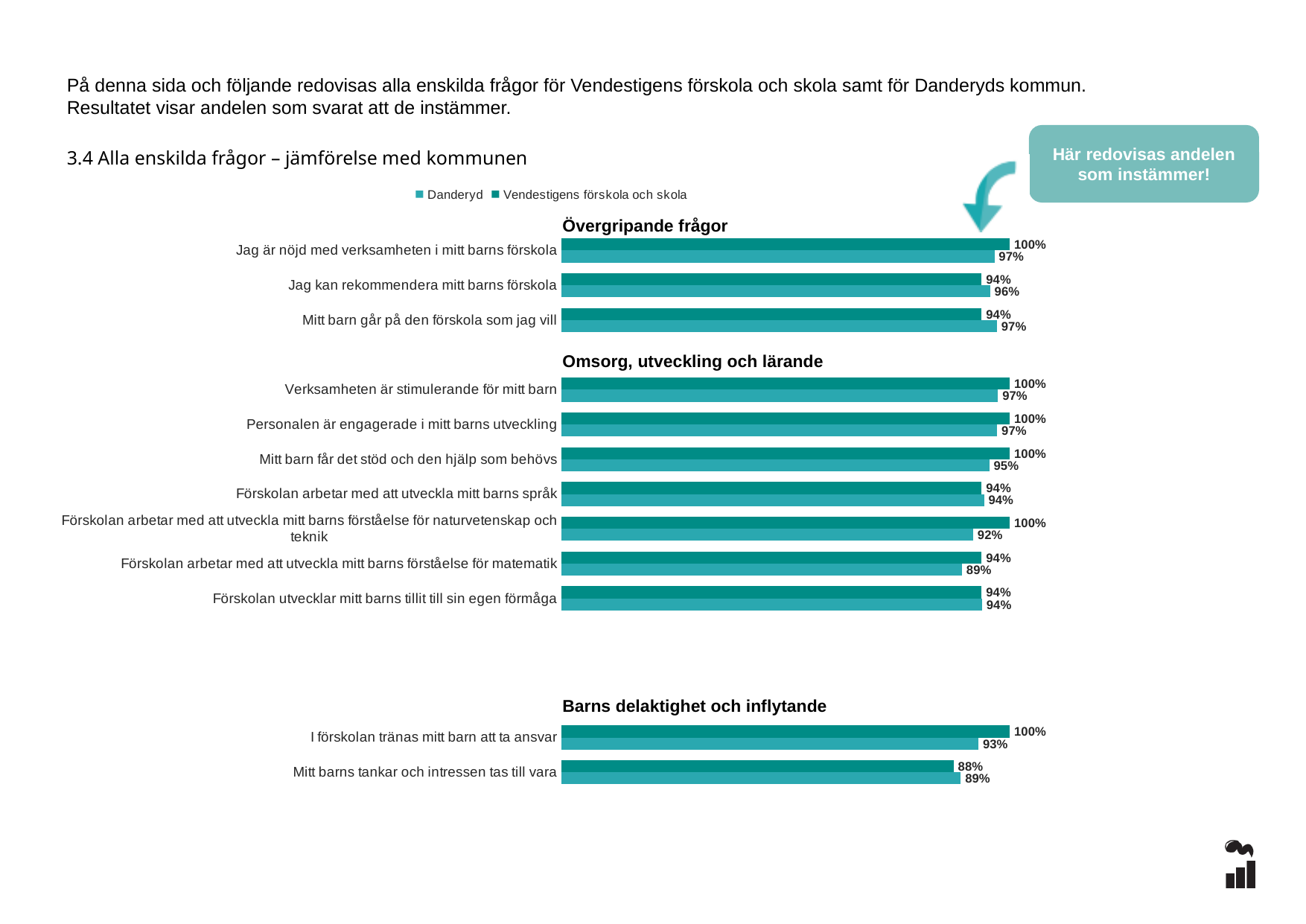
How many series does the legend list? 2 In the 'Barns delaktighet och inflytande' chart, what is the difference between Danderyd and Vendestigens förskola och skola on 'Mitt barns tankar och intressen tas till vara'? 1 percentage point In the 'Övergripande frågor' chart, what is the value for Vendestigens förskola och skola on 'Jag är nöjd med verksamheten i mitt barns förskola'? 100% In the 'Övergripande frågor' chart, which is larger on 'Mitt barn går på den förskola som jag vill': Vendestigens förskola och skola or Danderyd? Danderyd How many questions are shown in the 'Omsorg, utveckling och lärande' chart? 7 In the 'Omsorg, utveckling och lärande' chart, what is the difference between Vendestigens förskola och skola and Danderyd on 'Förskolan arbetar med att utveckla mitt barns förståelse för naturvetenskap och teknik'? 8 percentage points In the 'Övergripande frågor' chart, what is the value for Danderyd on 'Jag kan rekommendera mitt barns förskola'? 96% What kind of chart is used on this slide? Bar chart In the 'Omsorg, utveckling och lärande' chart, which question has the lowest Danderyd value? Förskolan arbetar med att utveckla mitt barns förståelse för matematik In the 'Omsorg, utveckling och lärande' chart, what is the value for Danderyd on 'Förskolan arbetar med att utveckla mitt barns förståelse för matematik'? 89% In the 'Barns delaktighet och inflytande' chart, which is larger on 'I förskolan tränas mitt barn att ta ansvar': Vendestigens förskola och skola or Danderyd? Vendestigens förskola och skola In the 'Barns delaktighet och inflytande' chart, what is the value for Vendestigens förskola och skola on 'Mitt barns tankar och intressen tas till vara'? 88%